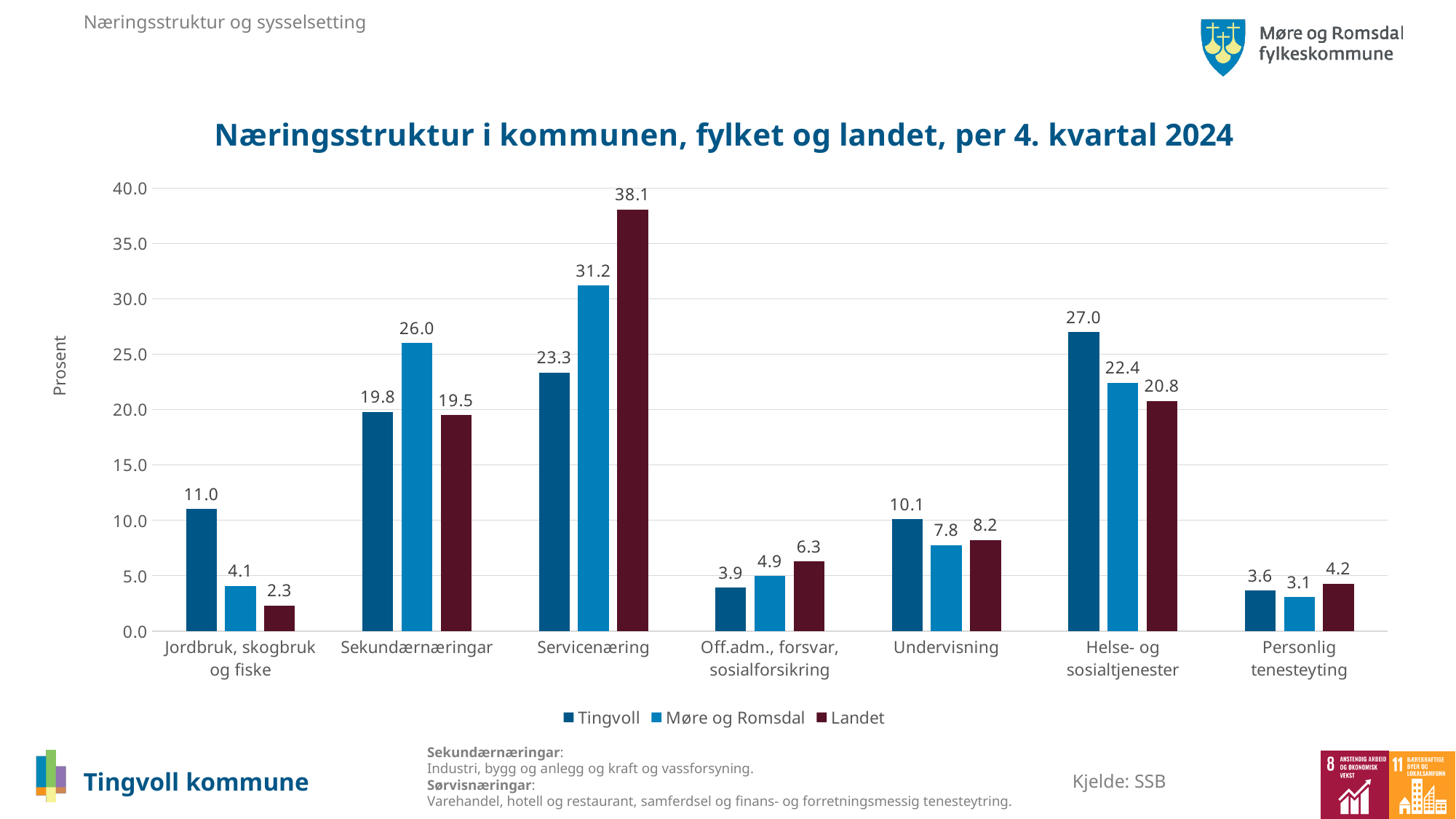
Which is larger in the Jordbruk, skogbruk og fiske category: Tingvoll or Landet? Tingvoll What is the title of the chart? Næringsstruktur i kommunen, fylket og landet, per 4. kvartal 2024 How many categories are shown on the x axis? 7 Which category has the highest value for the Landet series? Servicenæring Which category has the lowest value for the Tingvoll series? Personlig tenesteyting What is the value for Landet in the Helse- og sosialtjenester category? 20.8 What is the value for Tingvoll in the Servicenæring category? 23.3 How many series does the legend list? 3 What is the difference between the Landet and Tingvoll values in the Servicenæring category? 14.8 What kind of chart is shown on the slide? Bar chart What is the value for Møre og Romsdal in the Undervisning category? 7.8 Is the value for Møre og Romsdal in the Sekundærnæringar category greater or less than 25.0? greater